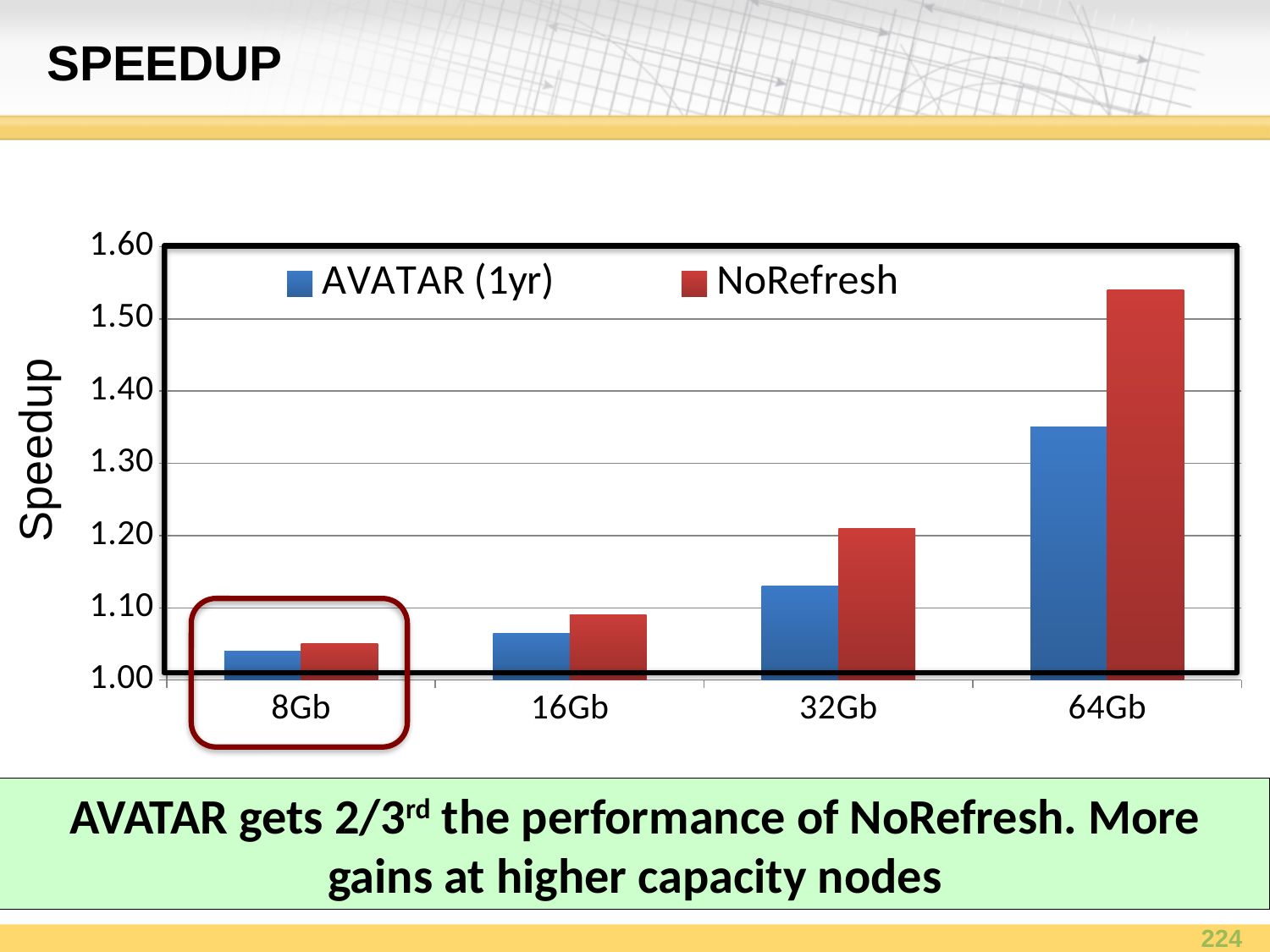
What is the label on the y axis of the chart? Speedup At 32Gb, which series has the larger speedup, AVATAR (1yr) or NoRefresh? NoRefresh Is the AVATAR (1yr) speedup at 64Gb greater or less than 1.40? less Is the AVATAR (1yr) speedup at 32Gb greater or less than 1.10? greater Which capacity has the highest NoRefresh speedup? 64Gb Is the NoRefresh speedup at 64Gb greater or less than 1.50? greater How many capacity categories are shown on the x axis? 4 What kind of chart is shown on the slide? bar chart How many series does the legend list? 2 Which capacity has the lowest AVATAR (1yr) speedup? 8Gb Do the speedup values for NoRefresh rise or fall as capacity increases from 8Gb to 64Gb? rise At 64Gb, which series has the larger speedup, AVATAR (1yr) or NoRefresh? NoRefresh